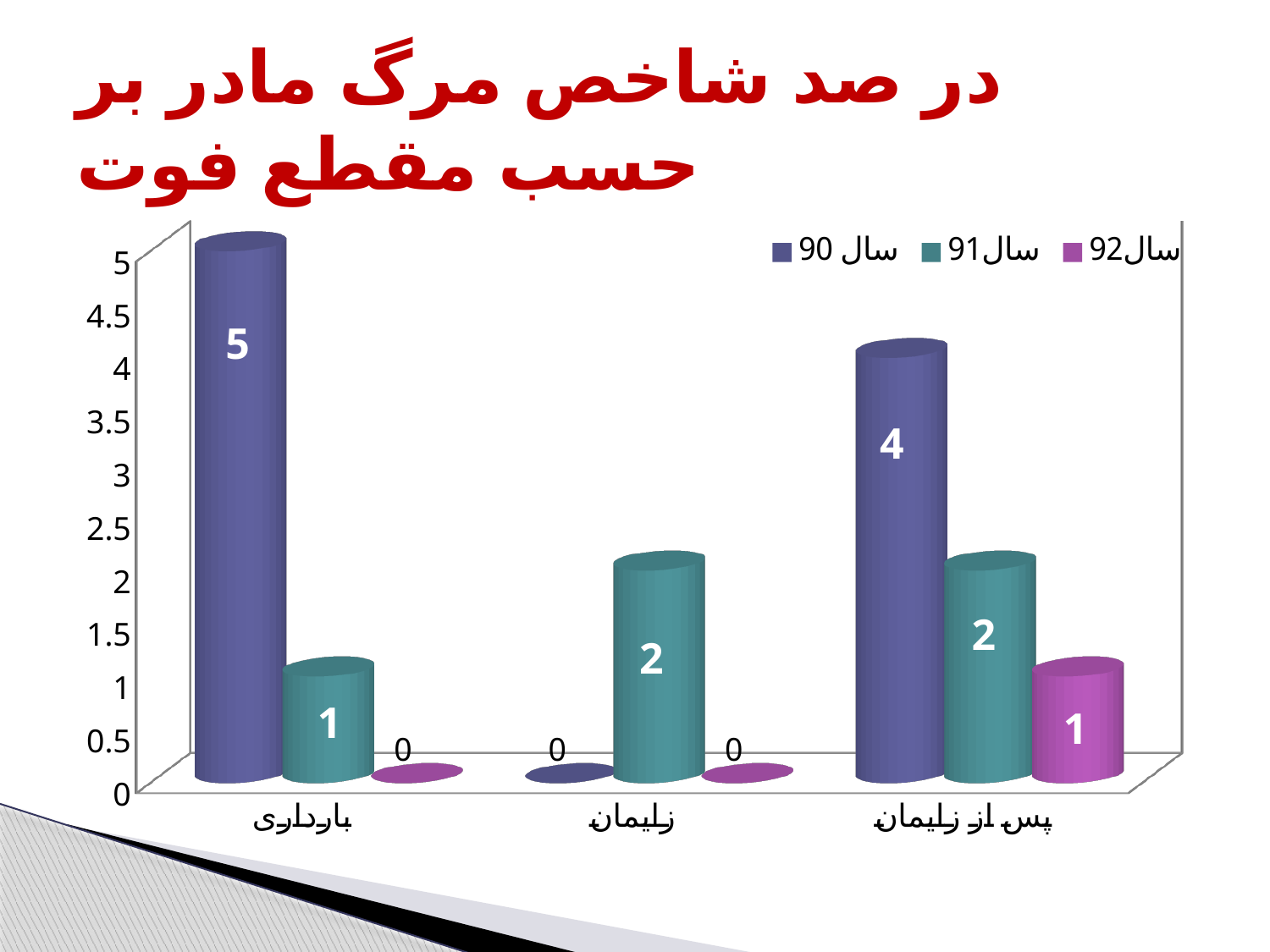
How many series does the legend list? 3 What is the value for سال 90 in the بارداری category? 5 Which category has the lowest value for سال91? بارداری What is the difference between the سال 90 values for بارداری and پس از زایمان? 1 What is the total of the three series values for پس از زایمان? 7 Which is larger: the سال 90 value or the سال91 value for پس از زایمان? سال 90 What is the value for سال 90 in the زایمان category? 0 What kind of chart is shown on the slide? bar chart What is the value for سال91 in the زایمان category? 2 What is the value for سال92 in the پس از زایمان category? 1 Which category has the highest value for سال 90? بارداری How many categories are shown on the x axis? 3